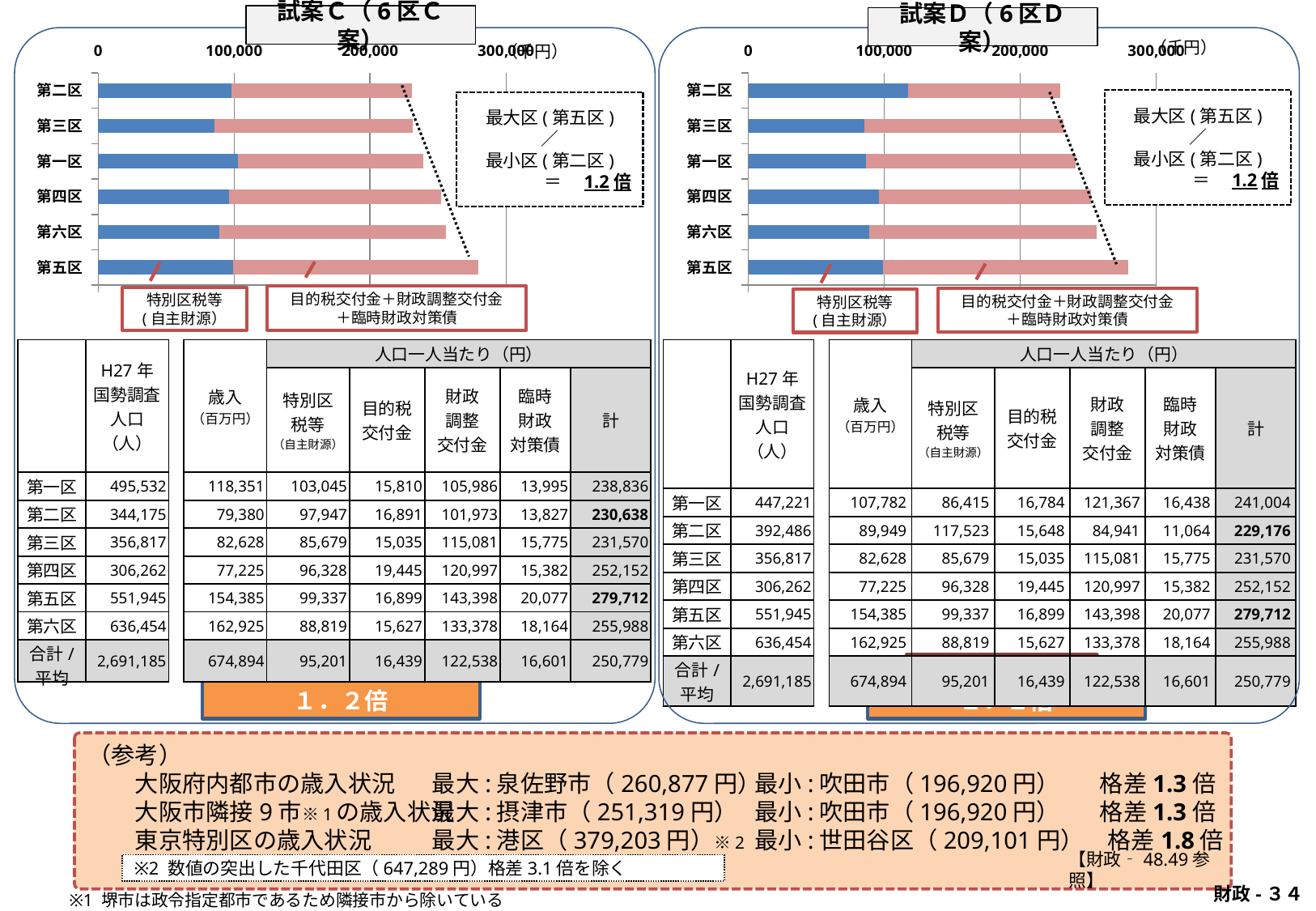
In the 試案D（6区D案） chart on the right, is the 特別区税等（自主財源） segment for 第一区 greater or less than 100,000? less How many districts (categories) are plotted in the 試案D（6区D案） chart on the right? 6 According to the annotation box in the 試案C（6区C案） chart on the left, what is the ratio of the largest district (第五区) to the smallest district (第二区)? 1.2倍 In the 試案D（6区D案） chart on the right, is the 特別区税等（自主財源） segment for 第二区 greater or less than 100,000? greater In the 試案C（6区C案） chart on the left, which district has the longest total bar? 第五区 In the 試案D（6区D案） chart on the right, what colour is the 特別区税等（自主財源） series? blue In the 試案C（6区C案） chart on the left, is the 特別区税等（自主財源） segment for 第三区 greater or less than 100,000? less What kind of chart is the 試案C（6区C案） chart on the left? bar chart In the 試案D（6区D案） chart on the right, which district has the shortest total bar? 第二区 How many series are shown in the 試案C（6区C案） chart on the left? 2 In the 試案D（6区D案） chart on the right, which district has the larger 特別区税等（自主財源） segment, 第二区 or 第一区? 第二区